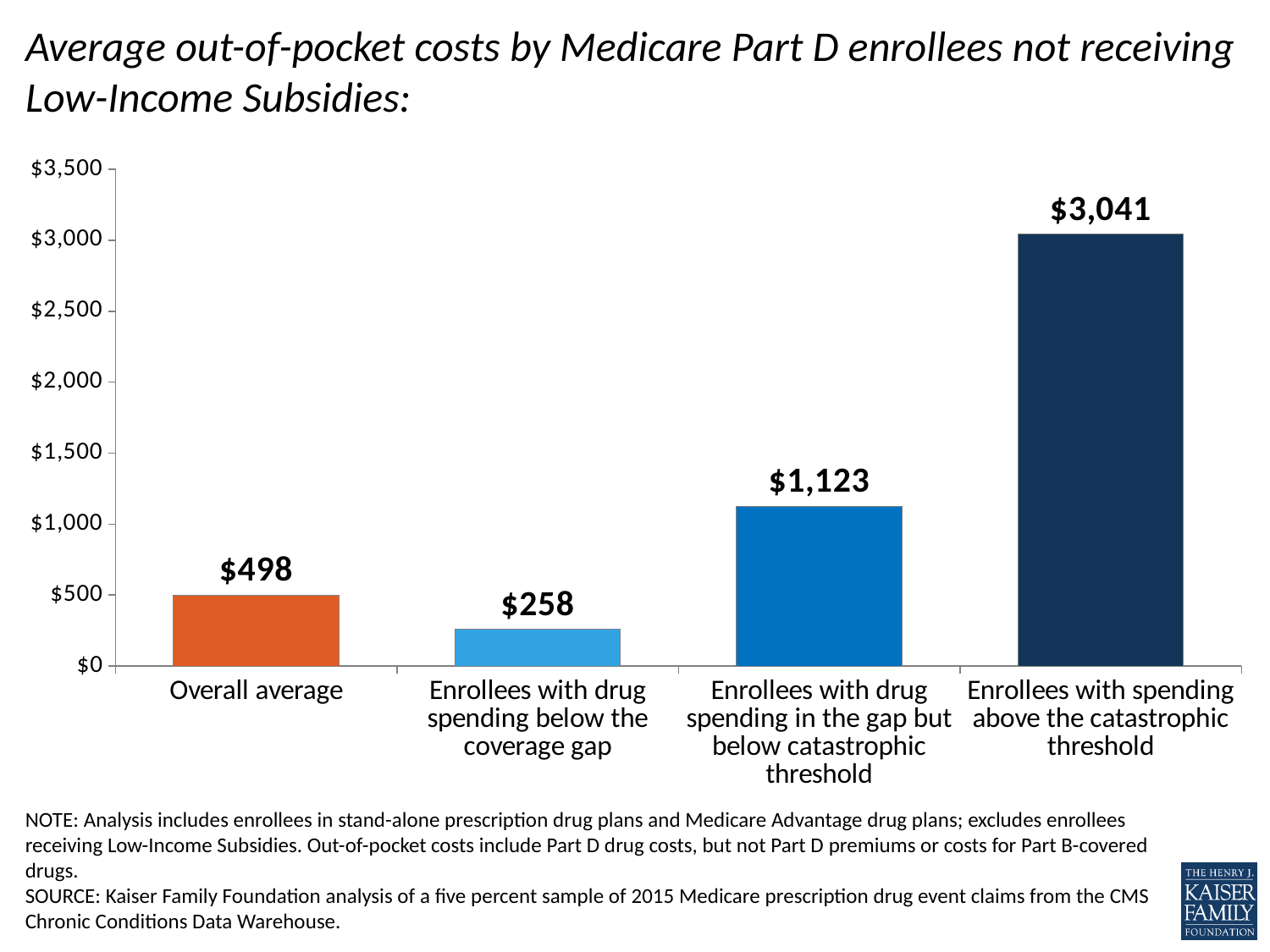
Which category has the highest average out-of-pocket cost? Enrollees with spending above the catastrophic threshold Which category has the lowest average out-of-pocket cost? Enrollees with drug spending below the coverage gap Is the value for enrollees with spending above the catastrophic threshold greater or less than $3,000? greater What is the average out-of-pocket cost for enrollees with spending above the catastrophic threshold? $3,041 What is the difference between the Overall average and the cost for enrollees with drug spending below the coverage gap? $240 What is the average out-of-pocket cost for enrollees with drug spending in the gap but below the catastrophic threshold? $1,123 How many categories are shown on the chart? 4 What type of chart is shown on the slide? Bar chart What is the average out-of-pocket cost for the Overall average category? $498 What is the average out-of-pocket cost for enrollees with drug spending below the coverage gap? $258 What is the difference in average out-of-pocket costs between enrollees with spending above the catastrophic threshold and enrollees with drug spending in the gap but below the catastrophic threshold? $1,918 Which is larger: the Overall average or the cost for enrollees with drug spending in the gap but below the catastrophic threshold? Enrollees with drug spending in the gap but below catastrophic threshold